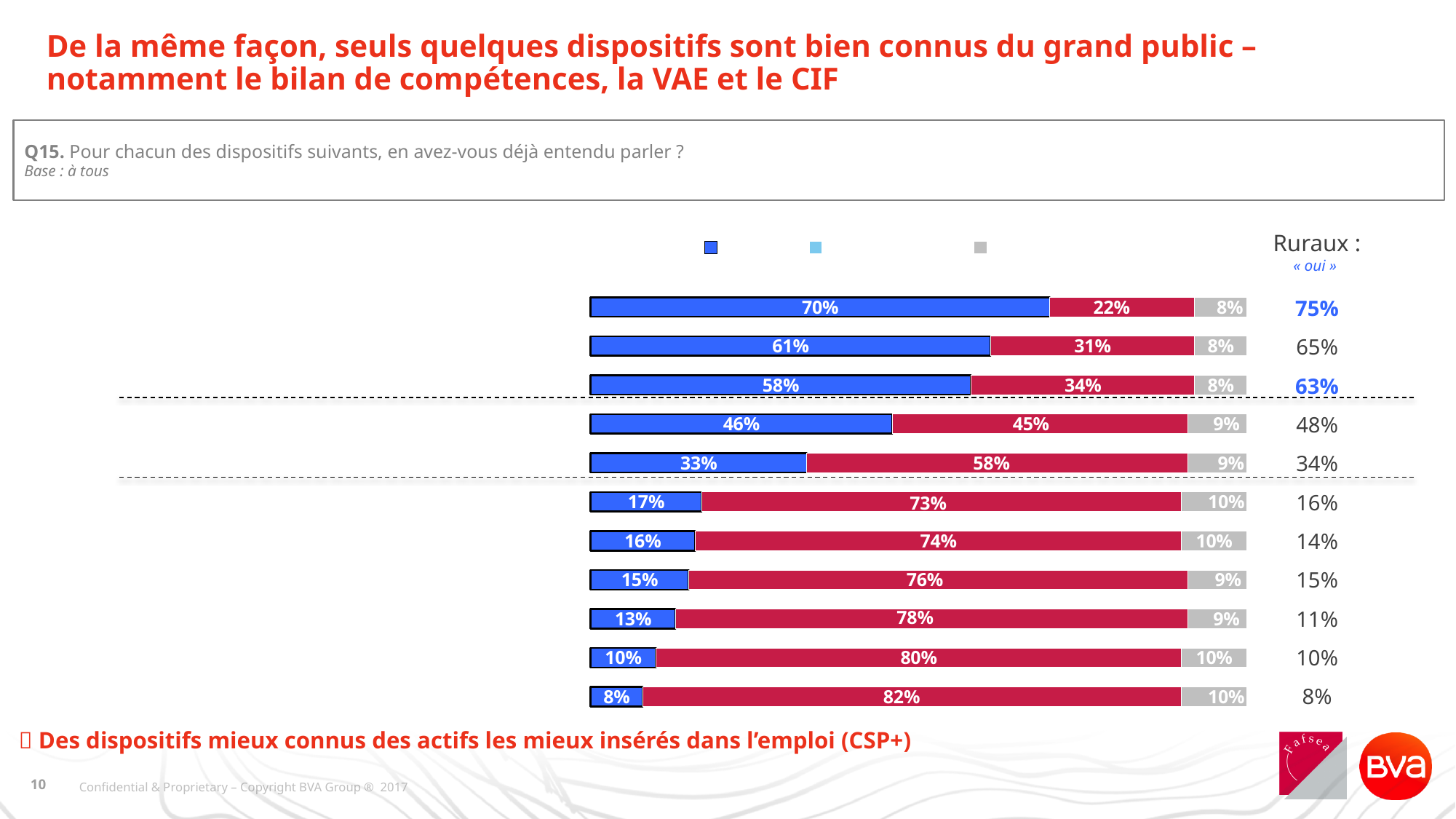
What is the value of the blue segment in the top bar? 70% What is the value of the red segment in the bottom bar? 82% Which bar has the largest blue segment? The top bar (70%) What is the value of the grey segment in the fourth bar from the top? 9% What is the difference between the blue segments of the top bar and the second bar? 9 points (70% vs 61%) In the fifth bar from the top, which is larger, the blue segment or the red segment? The red segment (58%) Do the blue segments increase or decrease from the top bar to the bottom bar? Decrease Which bar has the smallest blue segment? The bottom bar (8%) What is the total of the three segments in the top bar? 100% What kind of chart is shown on the slide? Stacked horizontal bar chart How many bars does the chart contain? 11 How many series does the legend show? 3